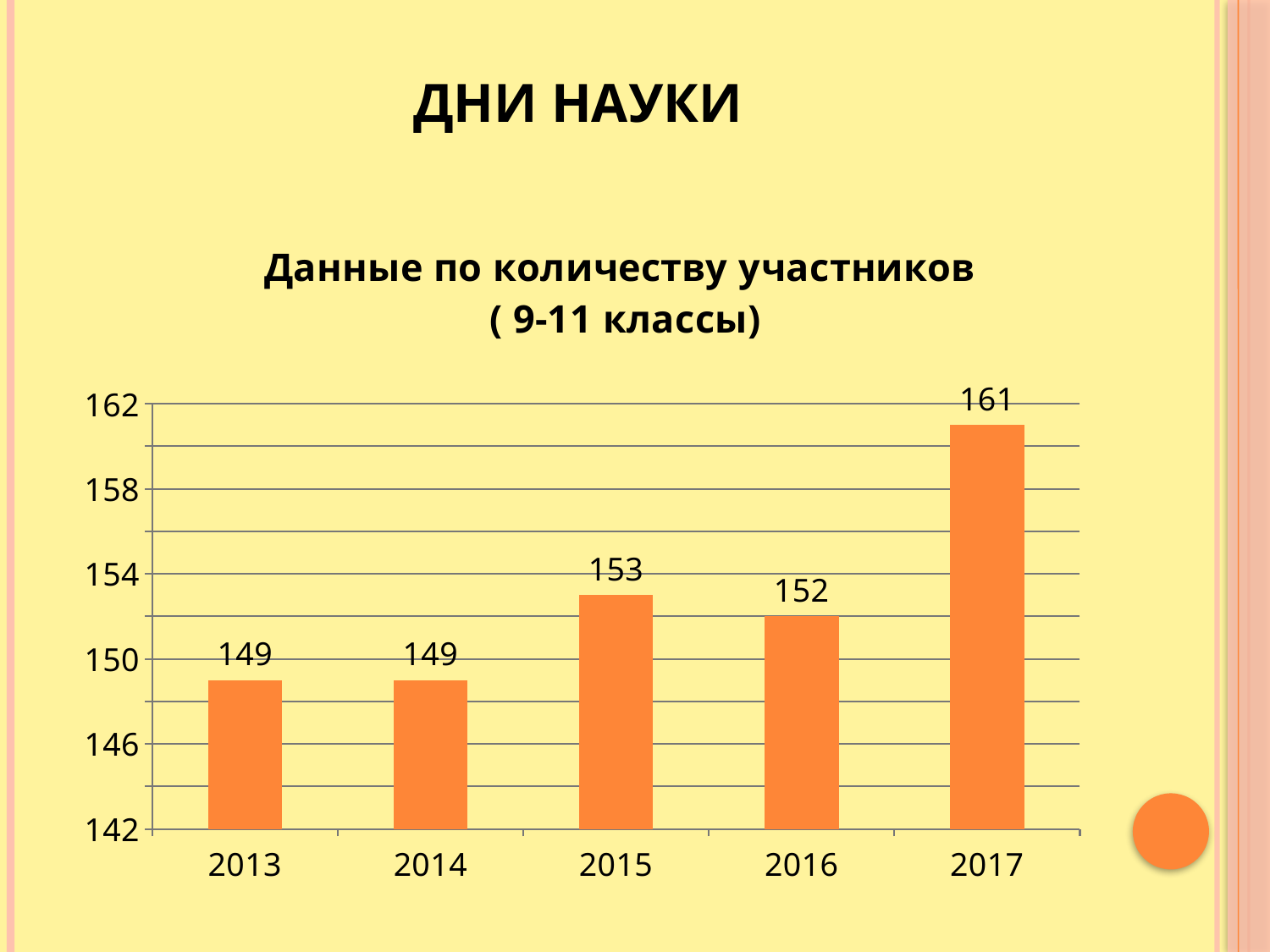
Which year has the highest number of participants? 2017 What kind of chart is shown on the slide? bar chart What is the difference in participants between 2017 and 2016? 9 What is the title of the chart? Данные по количеству участников ( 9-11 классы) What is the number of participants in 2015? 153 What is the number of participants in 2013? 149 What is the number of participants in 2016? 152 Which year has more participants, 2015 or 2016? 2015 What is the difference in participants between 2015 and 2014? 4 What is the number of participants in 2017? 161 How many years are shown on the chart? 5 Is the value for 2017 greater or less than 158? greater